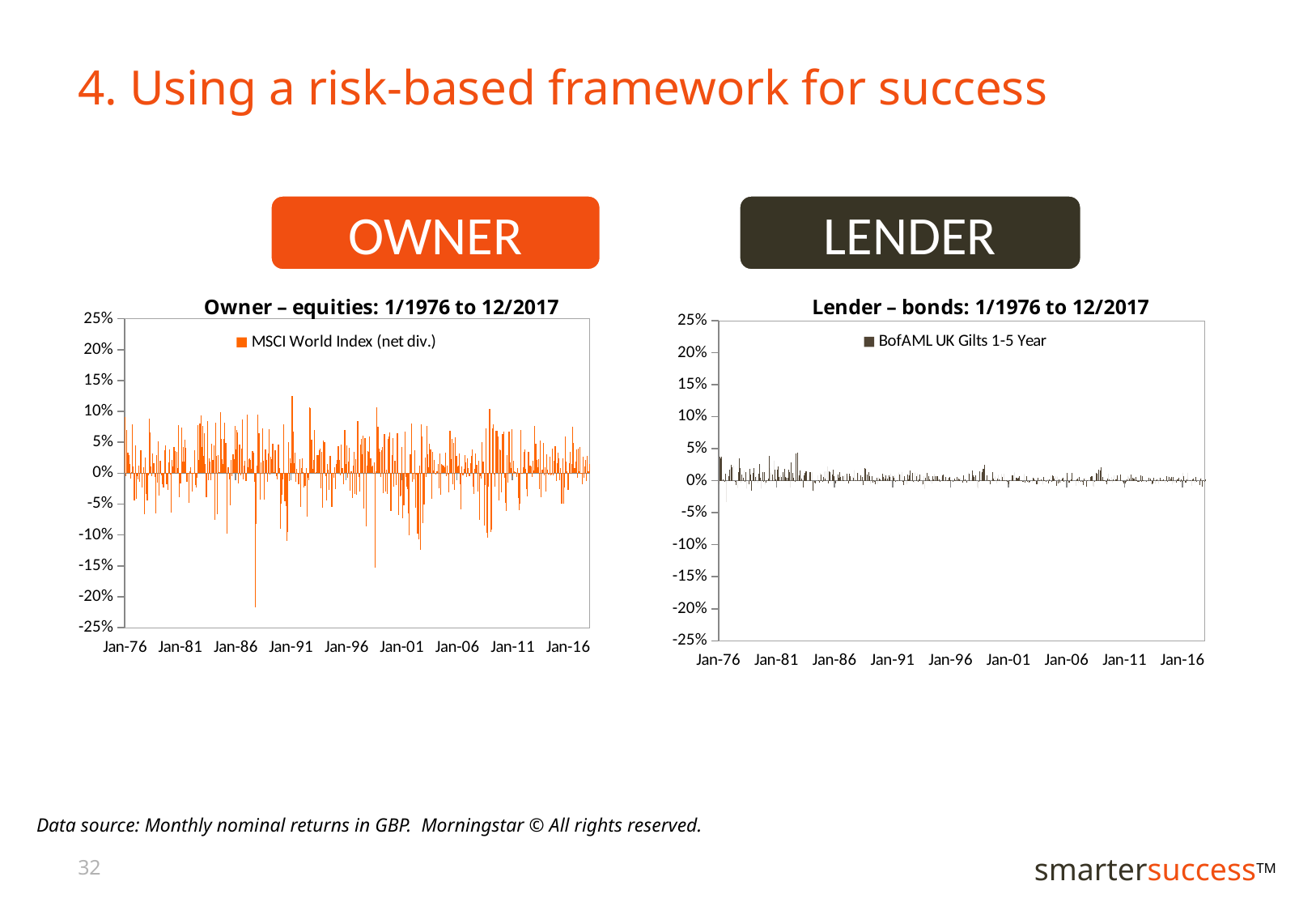
In the 'Owner – equities: 1/1976 to 12/2017' chart, is the lowest monthly return greater or less than -20%? less In the 'Lender – bonds: 1/1976 to 12/2017' chart, is the highest monthly return greater or less than 10%? less How many series does the legend of the 'Lender – bonds: 1/1976 to 12/2017' chart list? 1 In the 'Owner – equities: 1/1976 to 12/2017' chart, what series does the legend name? MSCI World Index (net div.) How many year labels are shown on the x axis of the 'Lender – bonds: 1/1976 to 12/2017' chart? 9 What kind of chart is the 'Lender – bonds: 1/1976 to 12/2017' chart? Bar chart In the 'Owner – equities: 1/1976 to 12/2017' chart, is the highest monthly return greater or less than 10%? greater Which chart shows the larger swings in monthly returns, 'Owner – equities' or 'Lender – bonds'? Owner – equities In the 'Lender – bonds: 1/1976 to 12/2017' chart, what series does the legend name? BofAML UK Gilts 1-5 Year How many series does the legend of the 'Owner – equities: 1/1976 to 12/2017' chart list? 1 What kind of chart is the 'Owner – equities: 1/1976 to 12/2017' chart? Bar chart